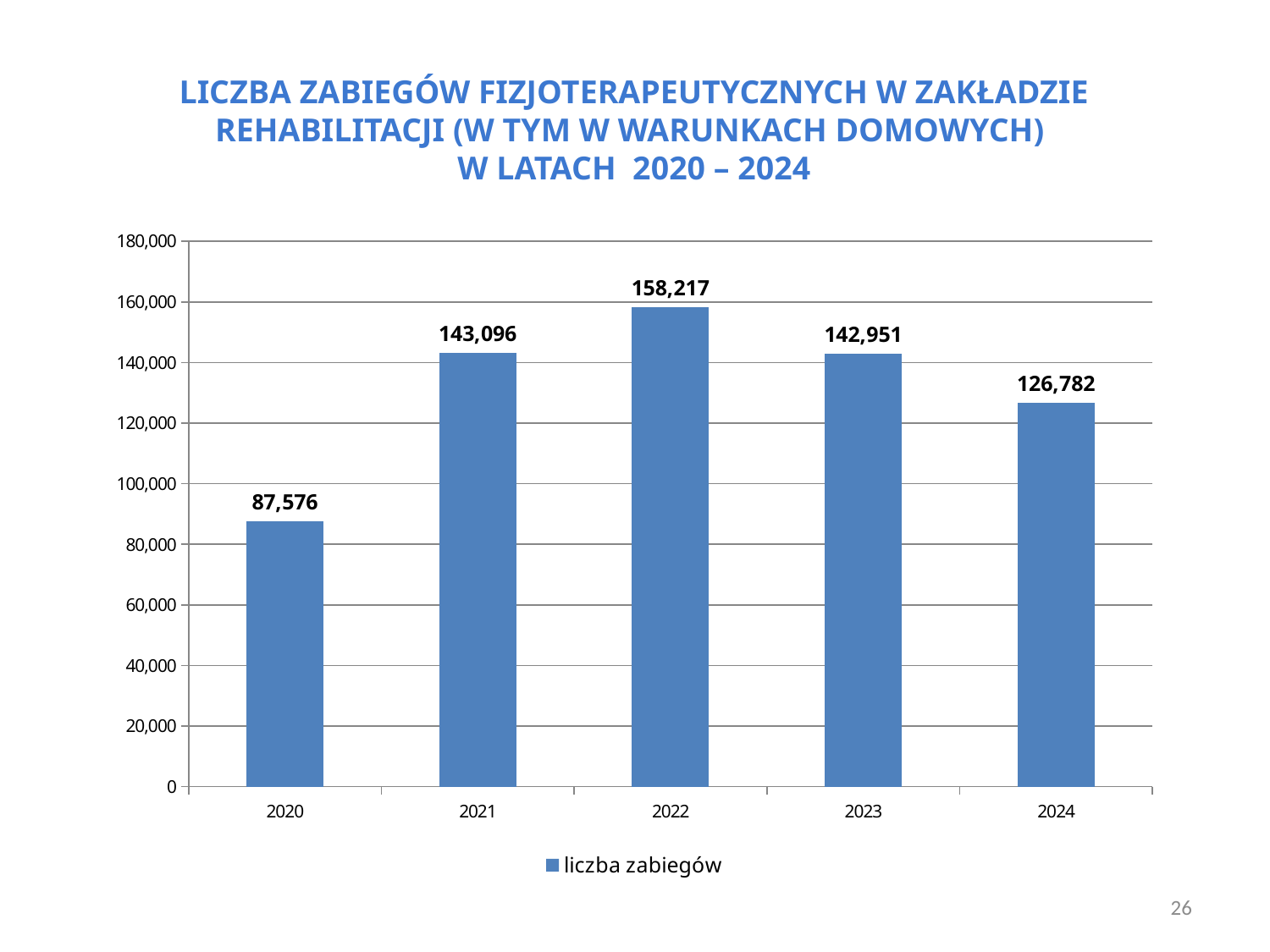
What is the series name shown in the legend? liczba zabiegów What is the value for 2020? 87,576 What is the value for 2022? 158,217 What kind of chart is shown on the slide? bar chart Which year has the lowest value? 2020 Which year has the highest value? 2022 What is the difference between the values for 2022 and 2021? 15,121 How many years are shown on the x axis? 5 Which is larger, the value for 2021 or the value for 2024? 2021 What is the value for 2024? 126,782 What is the difference between the values for 2023 and 2024? 16,169 Is the value for 2020 greater or less than 100,000? less